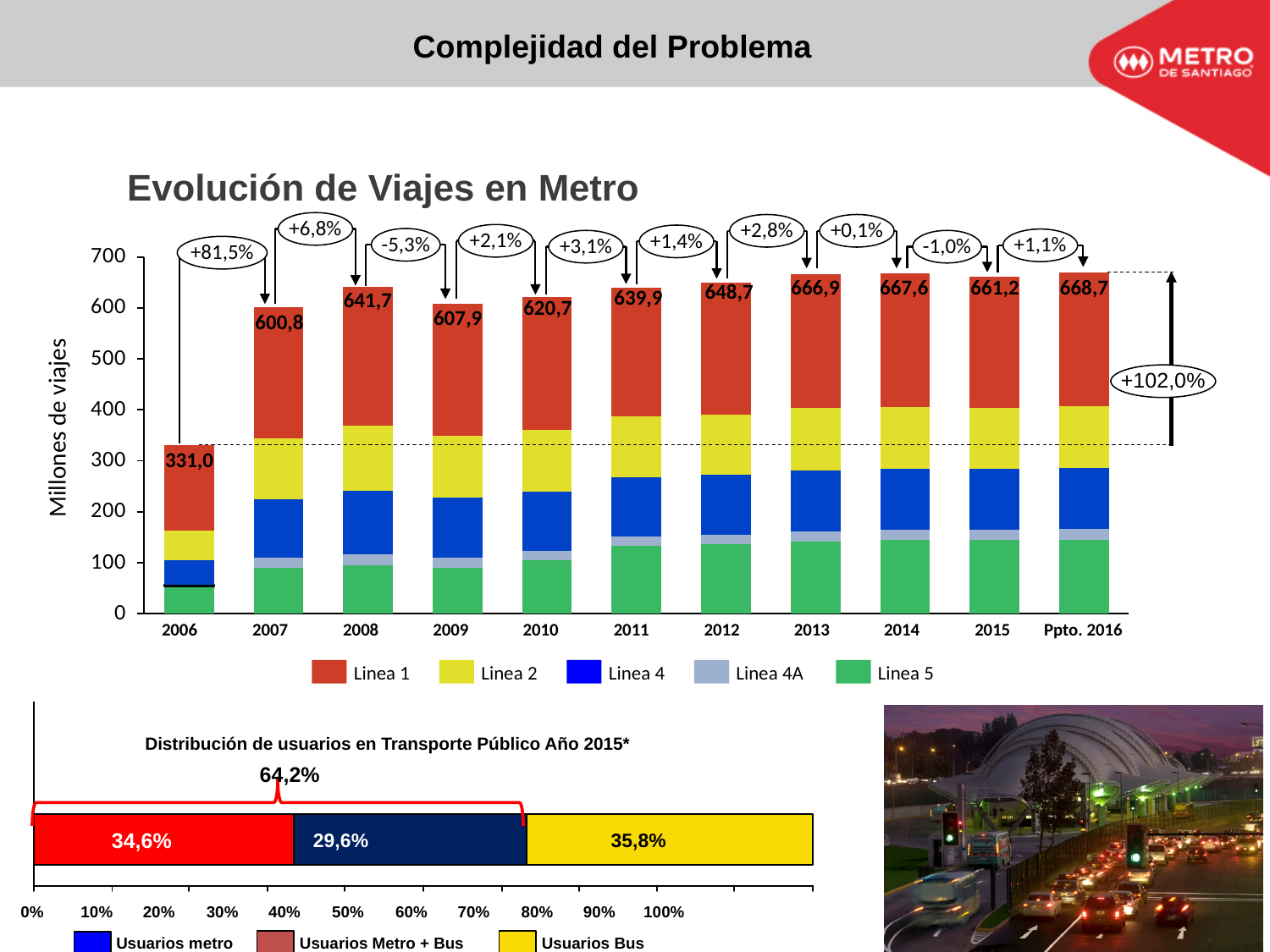
In the chart 'Evolución de Viajes en Metro', how many years (categories) are shown on the x axis? 11 In the chart 'Distribución de usuarios en Transporte Público Año 2015*', which segment is the largest? Usuarios Bus In the chart 'Evolución de Viajes en Metro', which total is larger, 2008 or 2009? 2008 In the chart 'Evolución de Viajes en Metro', how many series does the legend list? 5 In the chart 'Distribución de usuarios en Transporte Público Año 2015*', what is the combined share of Usuarios metro and Usuarios Metro + Bus? 64,2% In the chart 'Evolución de Viajes en Metro', what is the total value labelled for 2006? 331,0 In the chart 'Distribución de usuarios en Transporte Público Año 2015*', what share is shown for Usuarios Bus? 35,8% In the chart 'Evolución de Viajes en Metro', which year has the lowest total? 2006 In the chart 'Evolución de Viajes en Metro', what is the difference between the totals for 2007 and 2006? 269,8 In the chart 'Evolución de Viajes en Metro', what percentage change is shown between 2006 and 2007? +81,5% In the chart 'Evolución de Viajes en Metro', what is the total value labelled for Ppto. 2016? 668,7 What kind of chart is 'Evolución de Viajes en Metro'? Stacked bar chart